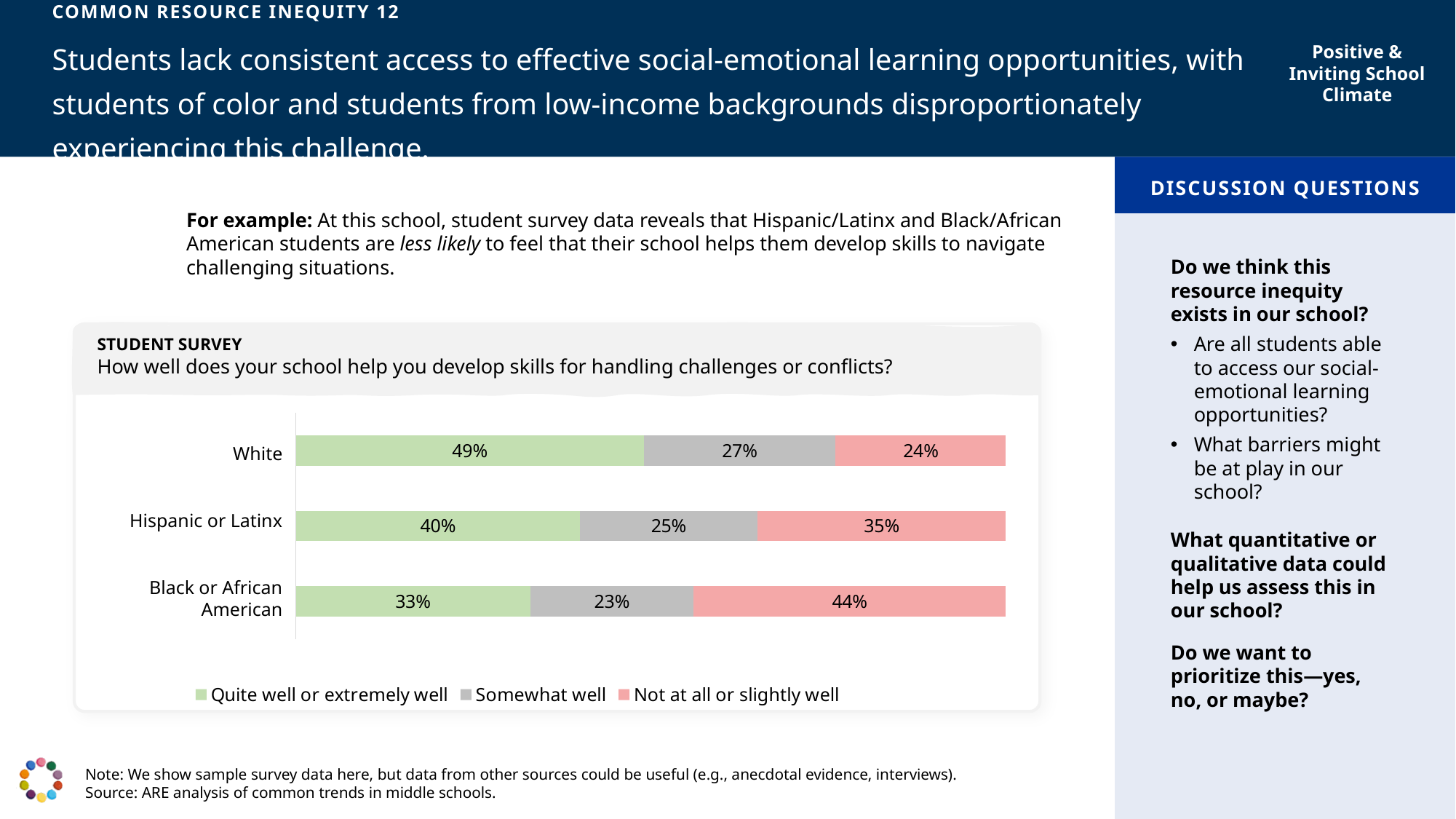
How many response categories does the legend list? 3 What percentage of Black or African American students answered "Not at all or slightly well"? 44% What type of chart is shown on the slide? Stacked bar chart What percentage of Hispanic or Latinx students answered "Somewhat well"? 25% What survey question does the chart show responses to? How well does your school help you develop skills for handling challenges or conflicts? What is the total of the three segments for the Hispanic or Latinx bar? 100% What percentage of White students answered "Quite well or extremely well"? 49% Which is larger: the "Quite well or extremely well" share for Hispanic or Latinx students or for Black or African American students? Hispanic or Latinx How many student groups are shown in the chart? 3 Which group has the lowest share answering "Not at all or slightly well"? White What is the difference between the "Not at all or slightly well" shares for Black or African American students and White students? 20 percentage points Which group has the highest share answering "Quite well or extremely well"? White